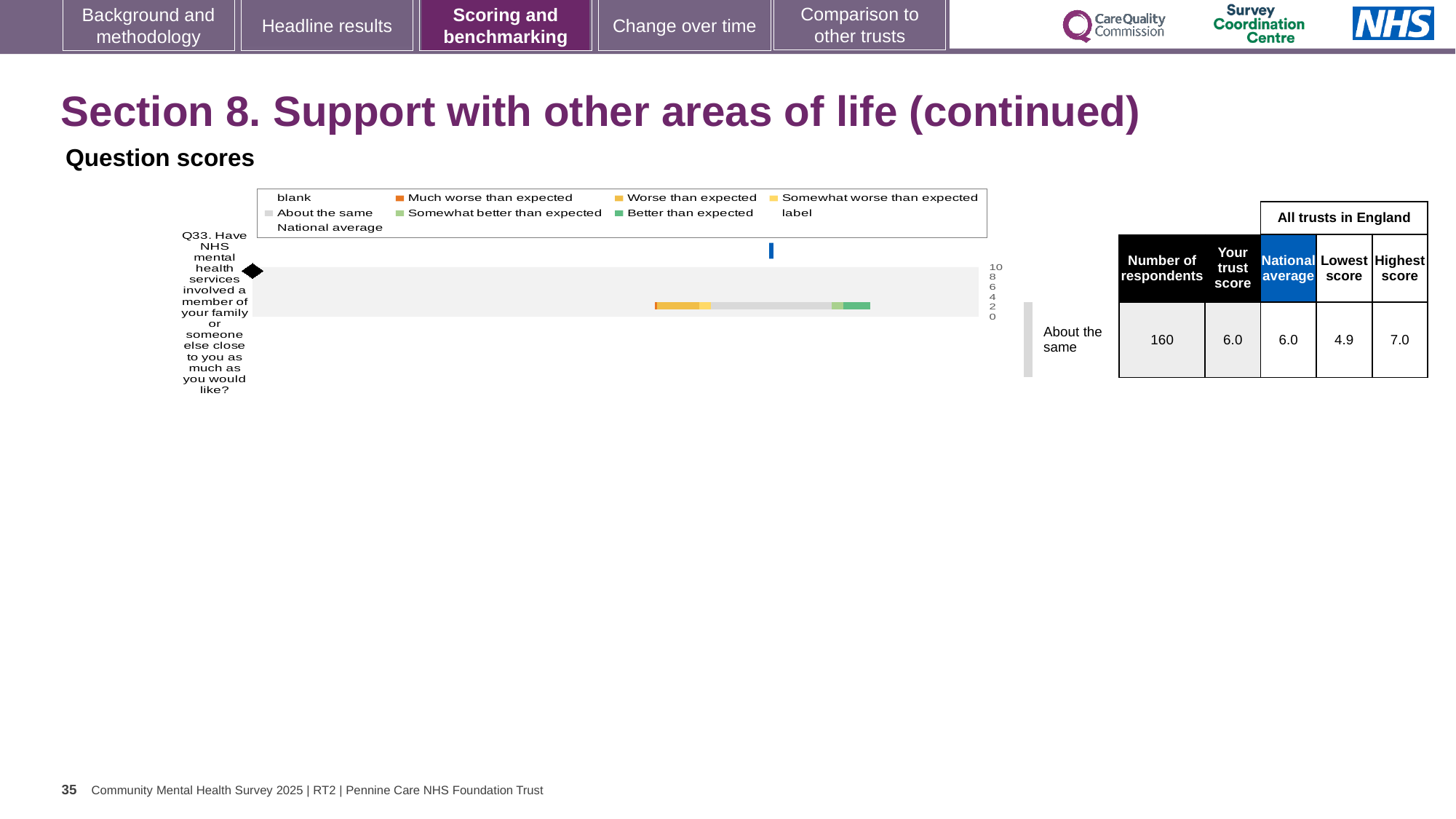
What is the lowest score among all trusts in England for Q33? 4.9 What is the national average for Q33 shown in the table beside the chart? 6.0 How many respondents answered Q33? 160 Which question is plotted in the Question scores chart? Q33. Have NHS mental health services involved a member of your family or someone else close to you as much as you would like? What is the trust's score for Q33 according to the table beside the chart? 6.0 What is the difference between the highest and lowest trust scores for Q33? 2.1 Is the national average marker for Q33 on the chart greater or less than 4? greater What kind of chart is shown under 'Question scores'? bar chart Which legend entry in the Question scores chart is shown in dark green? Better than expected What is the highest score among all trusts in England for Q33? 7.0 How many survey questions are plotted in the Question scores chart? 1 What benchmark category label is shown next to the bar for Q33? About the same